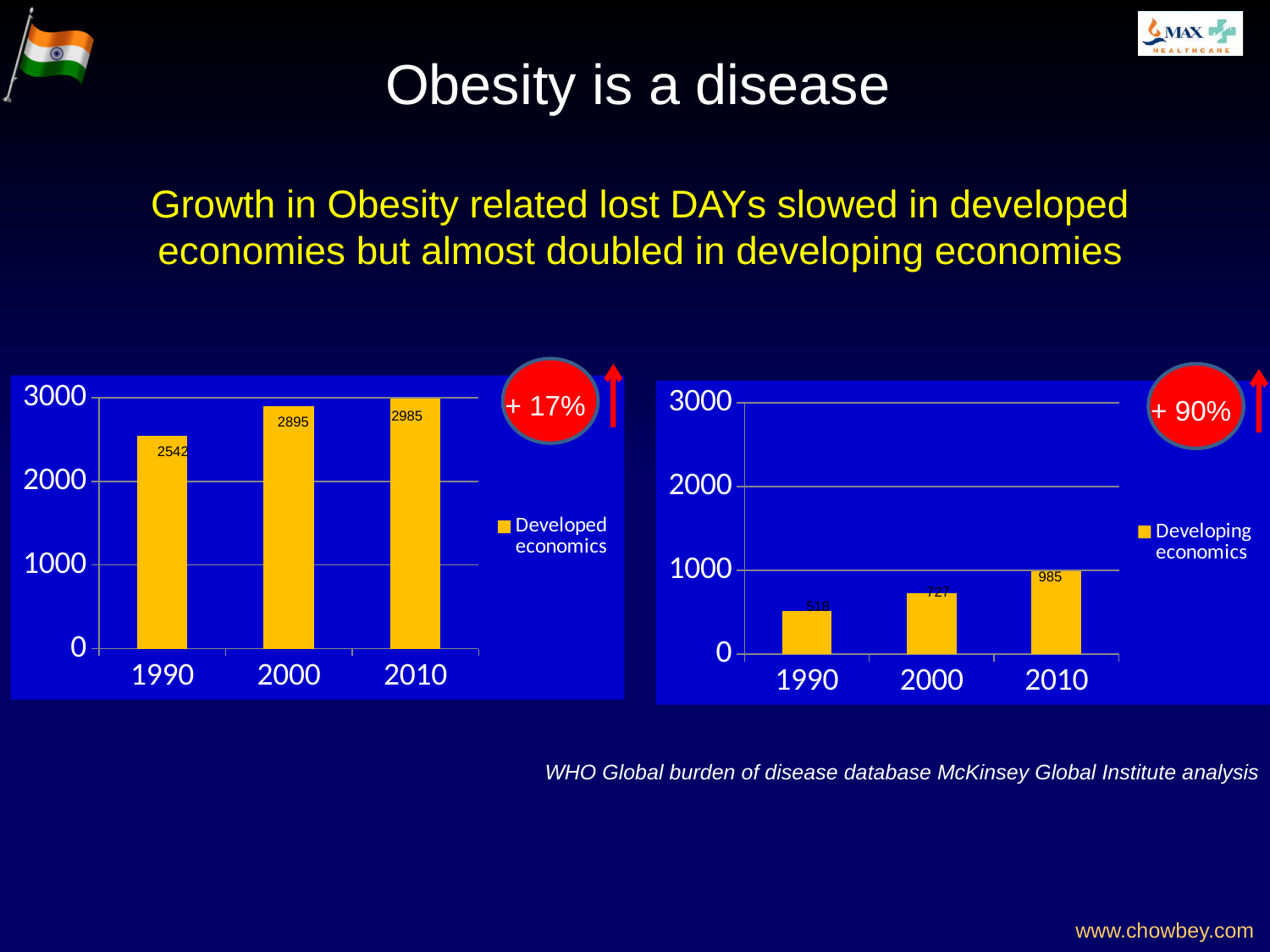
In the right chart (Developing economics), do the values rise or fall from 1990 to 2010? rise In the left chart (Developed economics), which year has the highest value? 2010 In the right chart (Developing economics), what is the value for 2010? 985 In the left chart (Developed economics), what is the difference between the 2000 and 1990 values? 353 In the left chart (Developed economics), what is the value for 2010? 2985 In the left chart (Developed economics), what is the value for 1990? 2542 In the right chart (Developing economics), what is the value for 2000? 727 In the right chart (Developing economics), is the value for 1990 greater or less than 1000? less What kind of chart is the left chart (Developed economics)? bar chart How many years are shown on the x axis of the right chart (Developing economics)? 3 In the right chart (Developing economics), which year has the lowest value? 1990 In the left chart (Developed economics), is the value for 2000 greater or less than 2000? greater